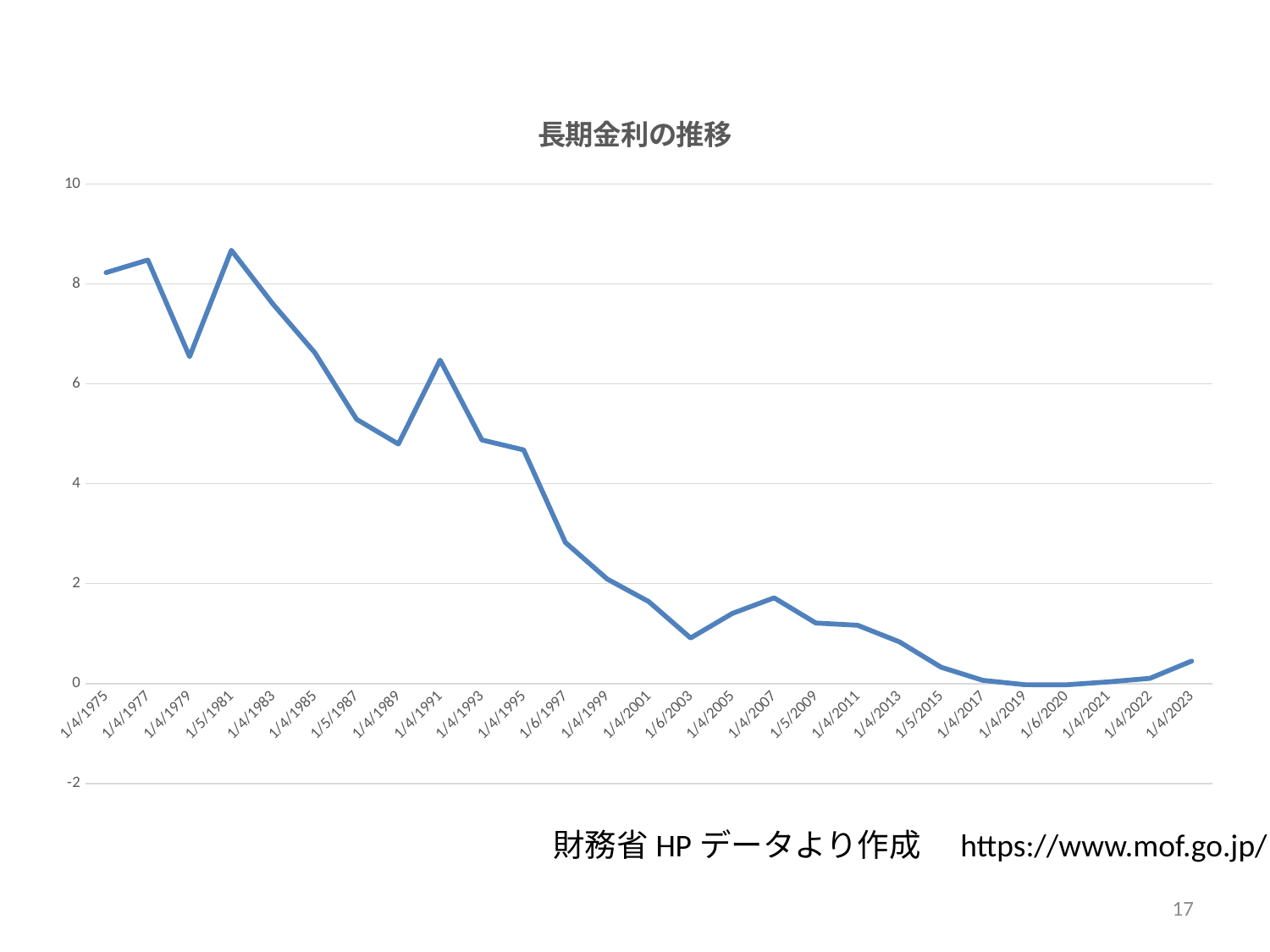
Is the value for 1/5/1987 greater or less than 6? less Is the value for 1/6/1997 greater or less than 4? less Overall, do the values rise or fall from 1/4/1975 to 1/4/2023? fall Is the value for 1/4/2023 greater or less than 2? less How many dates are labelled along the x axis of the chart? 27 Which is larger, the value for 1/6/2003 or the value for 1/4/2007? 1/4/2007 What is the title of the chart? 長期金利の推移 What kind of chart is shown on the slide? line chart Which is larger, the value for 1/4/1989 or the value for 1/4/1991? 1/4/1991